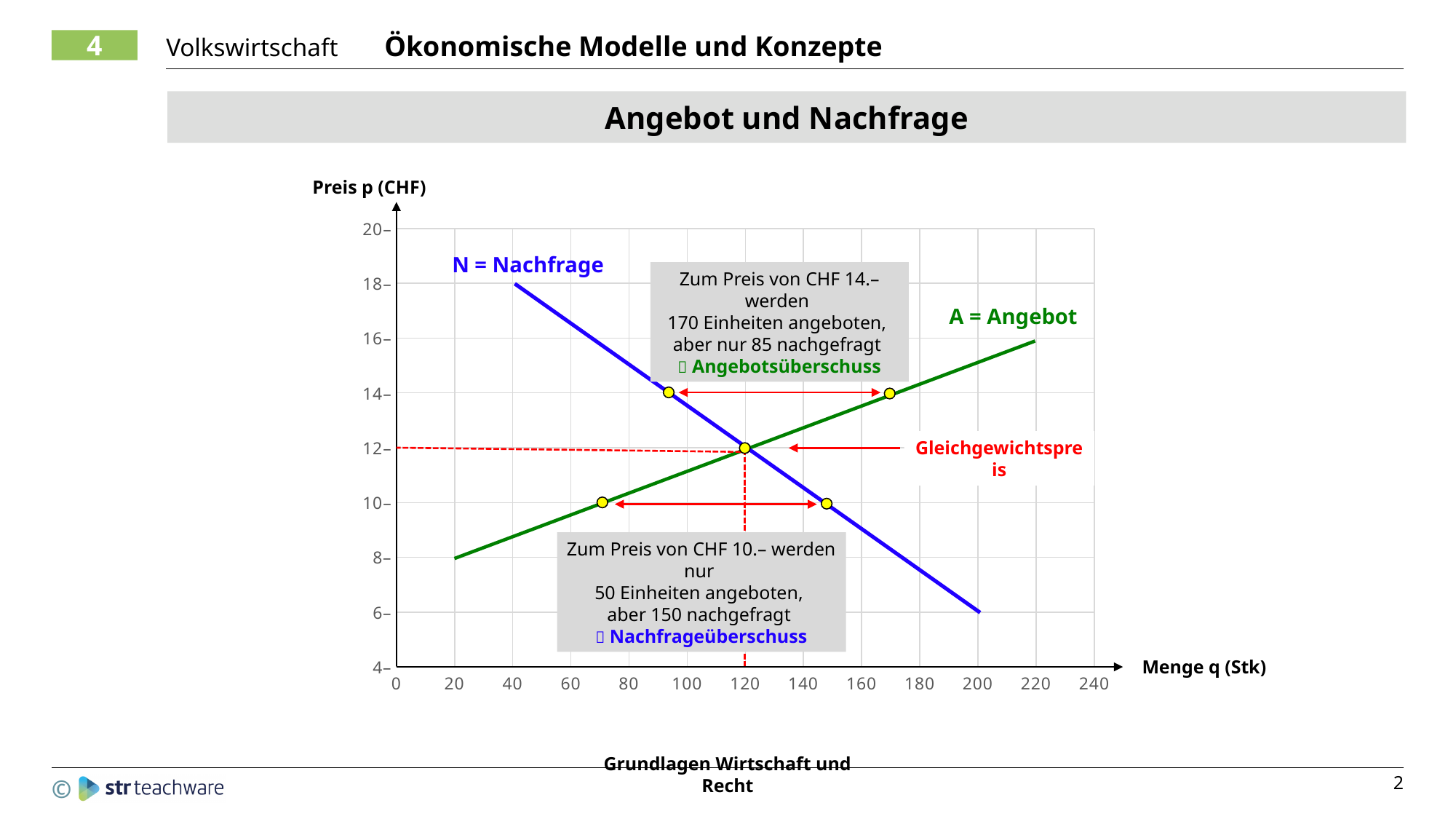
According to the chart annotation, how many units are demanded at a price of CHF 10.–? 150 Einheiten Does the Angebot (A) curve rise or fall as the quantity increases along the x axis? rises What is the label of the vertical axis of the chart? Preis p (CHF) According to the chart annotation, how many units are offered at a price of CHF 14.–? 170 Einheiten At a price of CHF 14.–, how many more units are offered than demanded? 85 At what quantity (Menge) do the Angebot and Nachfrage curves intersect? 120 What kind of chart is shown on the slide? line chart How many curves are plotted on the chart? 2 What is the Gleichgewichtspreis (equilibrium price) shown on the chart? 12 Does the Nachfrage (N) curve rise or fall as the quantity increases along the x axis? falls At a price of CHF 10.–, which is larger: the quantity offered or the quantity demanded? quantity demanded At a price of CHF 10.–, how many more units are demanded than offered? 100